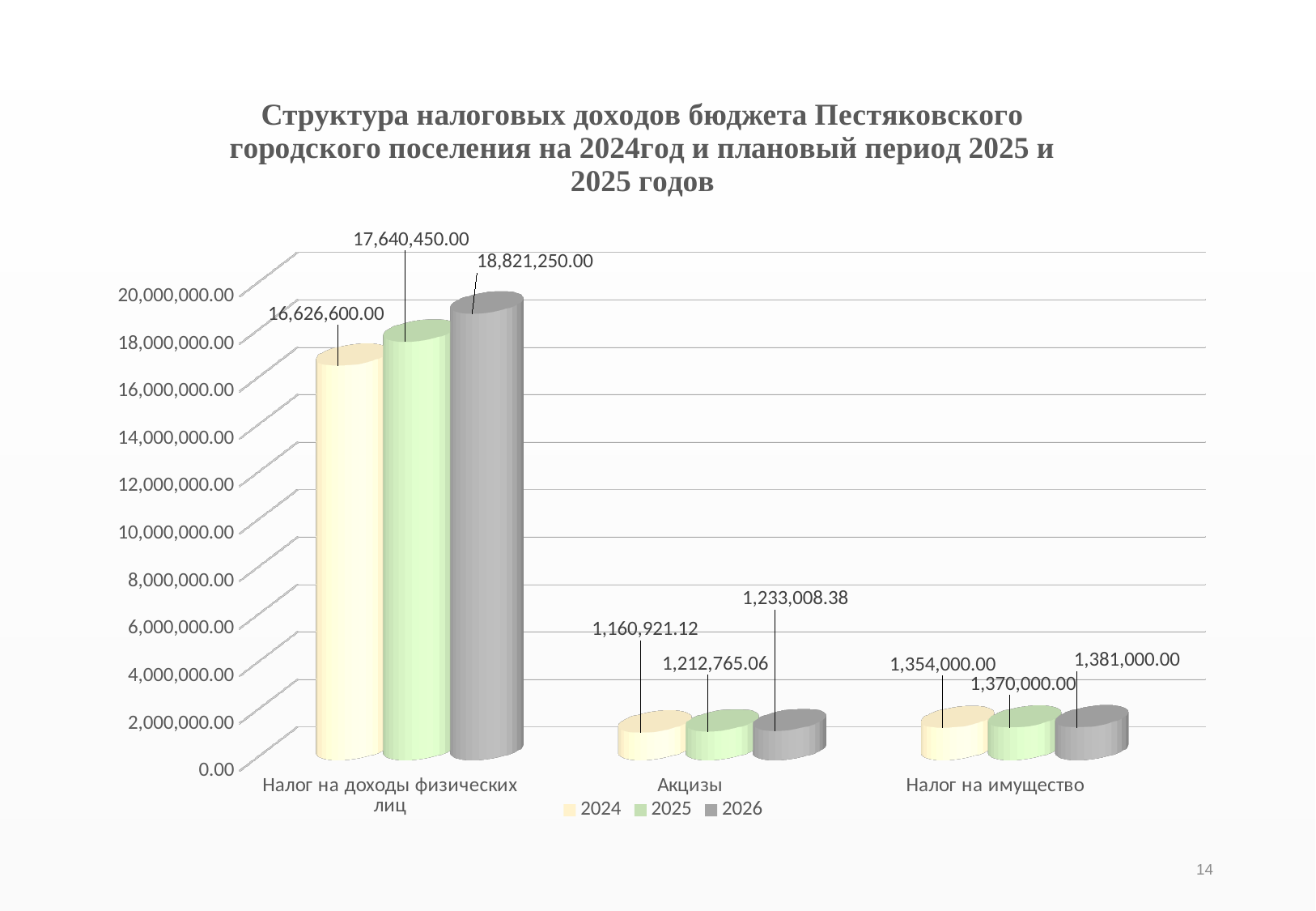
What kind of chart is shown on the slide? Bar chart What is the difference between the 2026 and 2024 values for Налог на имущество? 27,000.00 What is the value for Налог на доходы физических лиц in 2024? 16,626,600.00 What is the value for Акцизы in 2026? 1,233,008.38 Which category has the highest value in 2026? Налог на доходы физических лиц How many categories are shown on the x axis? 3 What is the difference between the 2026 and 2024 values for Налог на доходы физических лиц? 2,194,650.00 Which is larger: the 2024 value for Налог на имущество or the 2024 value for Акцизы? Налог на имущество Which category has the lowest value in 2024? Акцизы How many series does the legend list? 3 What is the value for Налог на имущество in 2025? 1,370,000.00 Is the 2025 value for Налог на доходы физических лиц greater or less than 16,000,000.00? greater